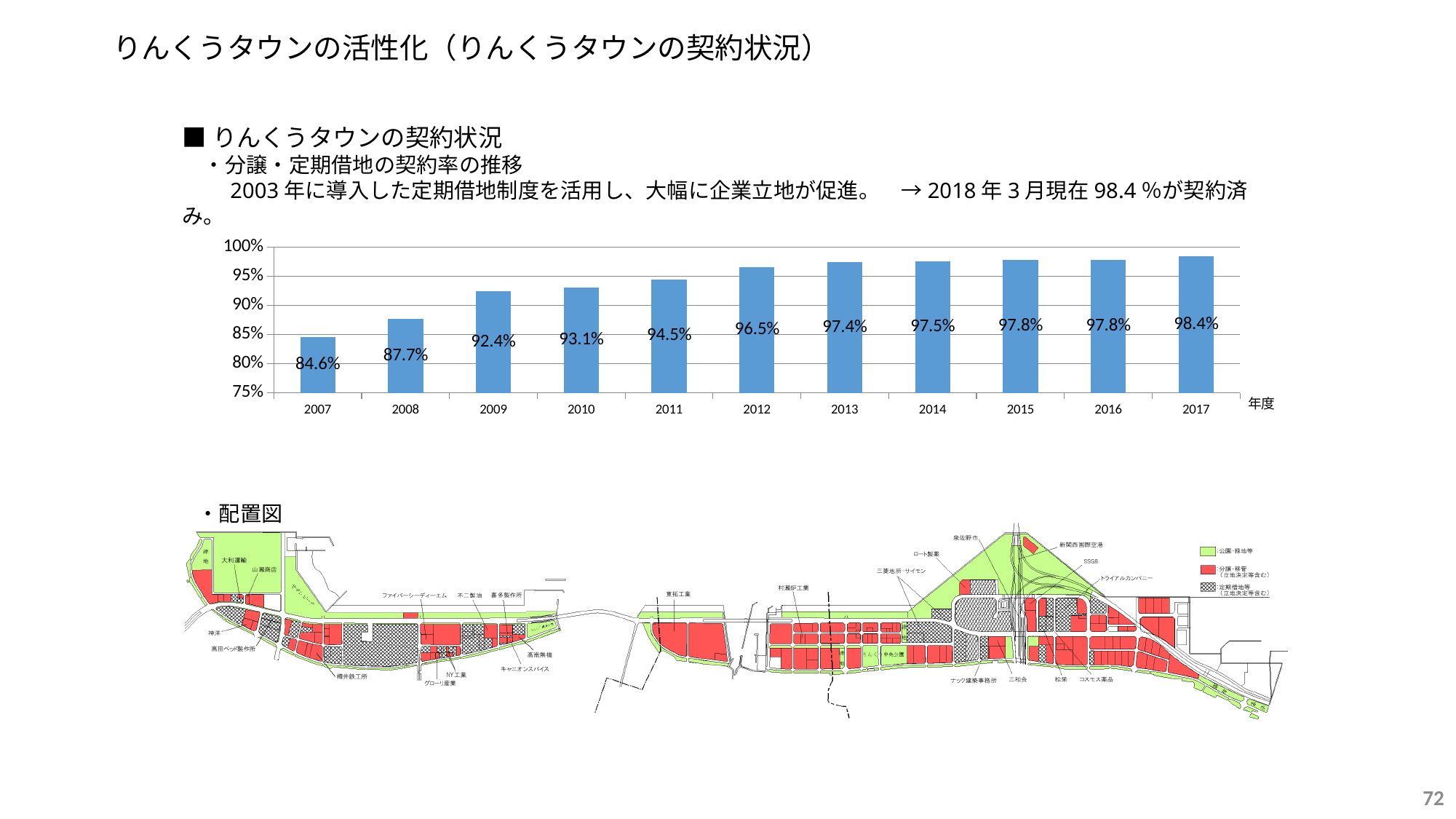
Do the contract rates rise or fall from 2007 to 2017? rise What is the difference between the contract rates for 2017 and 2007? 13.8% What is the contract rate for 2007? 84.6% Is the value for 2008 greater or less than 90%? less Which year has a higher contract rate, 2010 or 2011? 2011 Which year has the lowest contract rate? 2007 What kind of chart is used to show the contract rate by year? bar chart What is the contract rate for 2017? 98.4% What is the difference between the contract rates for 2009 and 2008? 4.7% How many years are shown on the x axis of the bar chart? 11 Which year has the highest contract rate? 2017 What is the contract rate for 2012? 96.5%